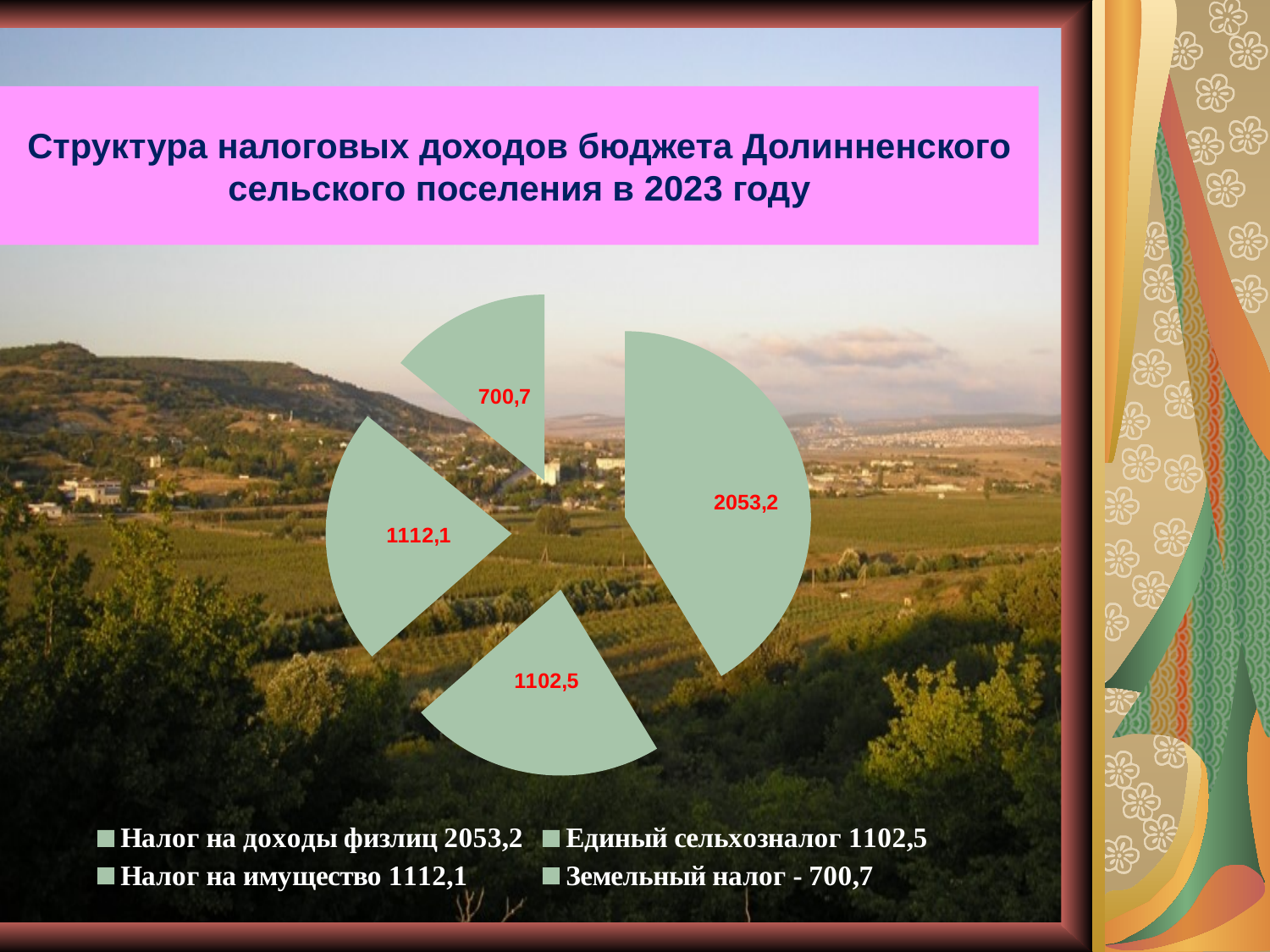
Which category has the largest slice of the pie? Налог на доходы физлиц What is the value shown for Налог на имущество? 1112,1 Which category has the smallest slice of the pie? Земельный налог How many slices does the pie chart have? 4 What is the value shown for Налог на доходы физлиц? 2053,2 What is the total of all four values in the pie chart? 4968,5 What is the difference between the values for Налог на доходы физлиц and Земельный налог? 1352,5 Which is larger, the value for Налог на имущество or the value for Единый сельхозналог? Налог на имущество What is the value shown for Земельный налог? 700,7 What is the value shown for Единый сельхозналог? 1102,5 What kind of chart is shown on the slide? pie chart What is the title of the chart on the slide? Структура налоговых доходов бюджета Долинненского сельского поселения в 2023 году